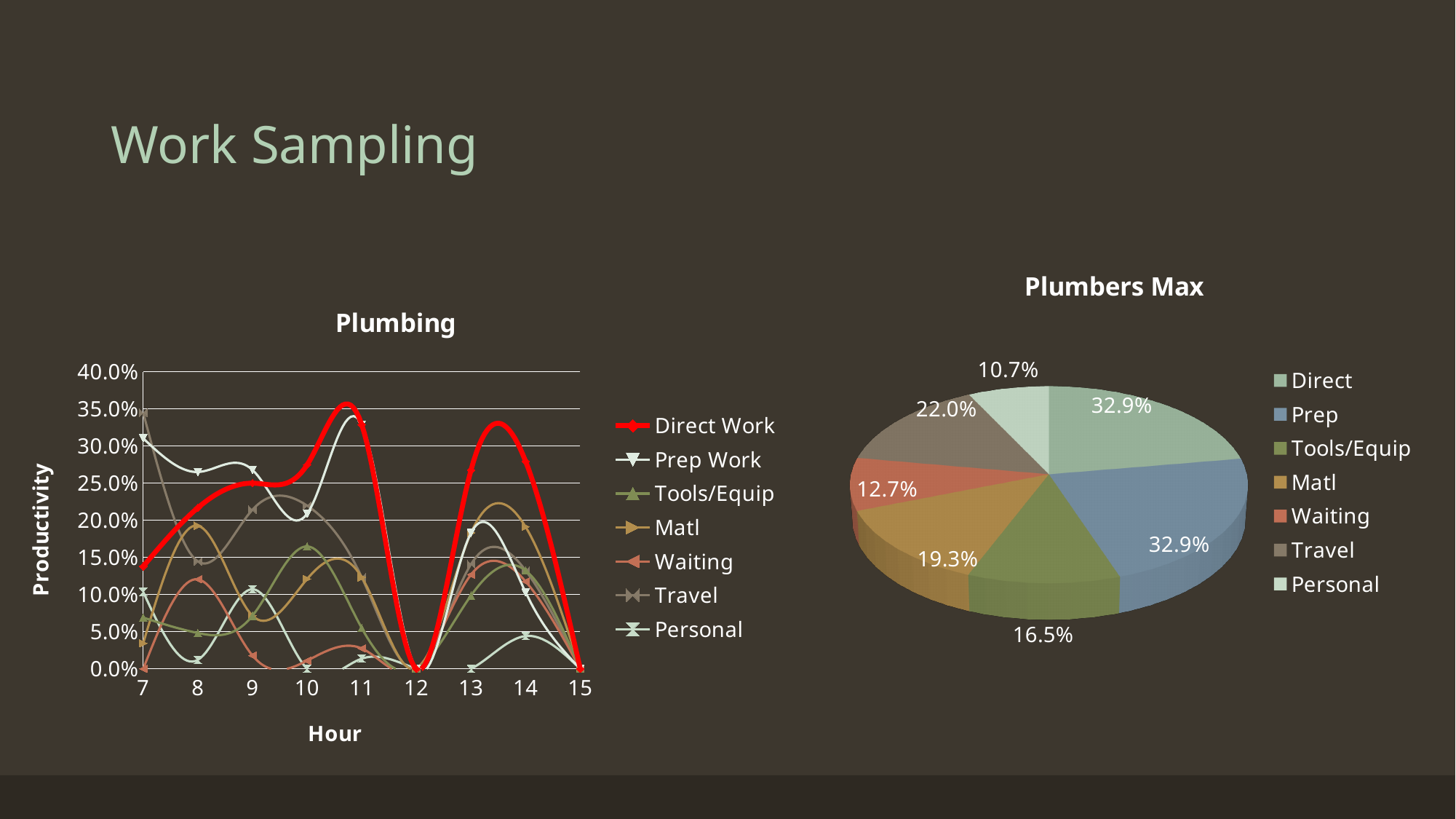
What kind of chart is "Plumbers Max"? pie chart In the "Plumbers Max" chart, which category has the smallest slice? Personal In the "Plumbing" chart, is the Direct Work value at hour 12 greater or less than 5.0%? less In the "Plumbers Max" chart, what percentage is shown for Personal? 10.7% What is the label on the vertical axis of the "Plumbing" chart? Productivity In the "Plumbers Max" chart, what is the difference between the Matl and Tools/Equip percentages? 2.8% How many hours are plotted along the x axis of the "Plumbing" chart? 9 In the "Plumbing" chart, is the Direct Work value at hour 11 greater or less than 30.0%? greater What kind of chart is the "Plumbing" chart on the left? line chart In the "Plumbers Max" chart, what percentage is shown for Travel? 22.0% How many series does the legend of the "Plumbing" chart list? 7 In the "Plumbing" chart, is the Prep Work value at hour 7 greater or less than 25.0%? greater